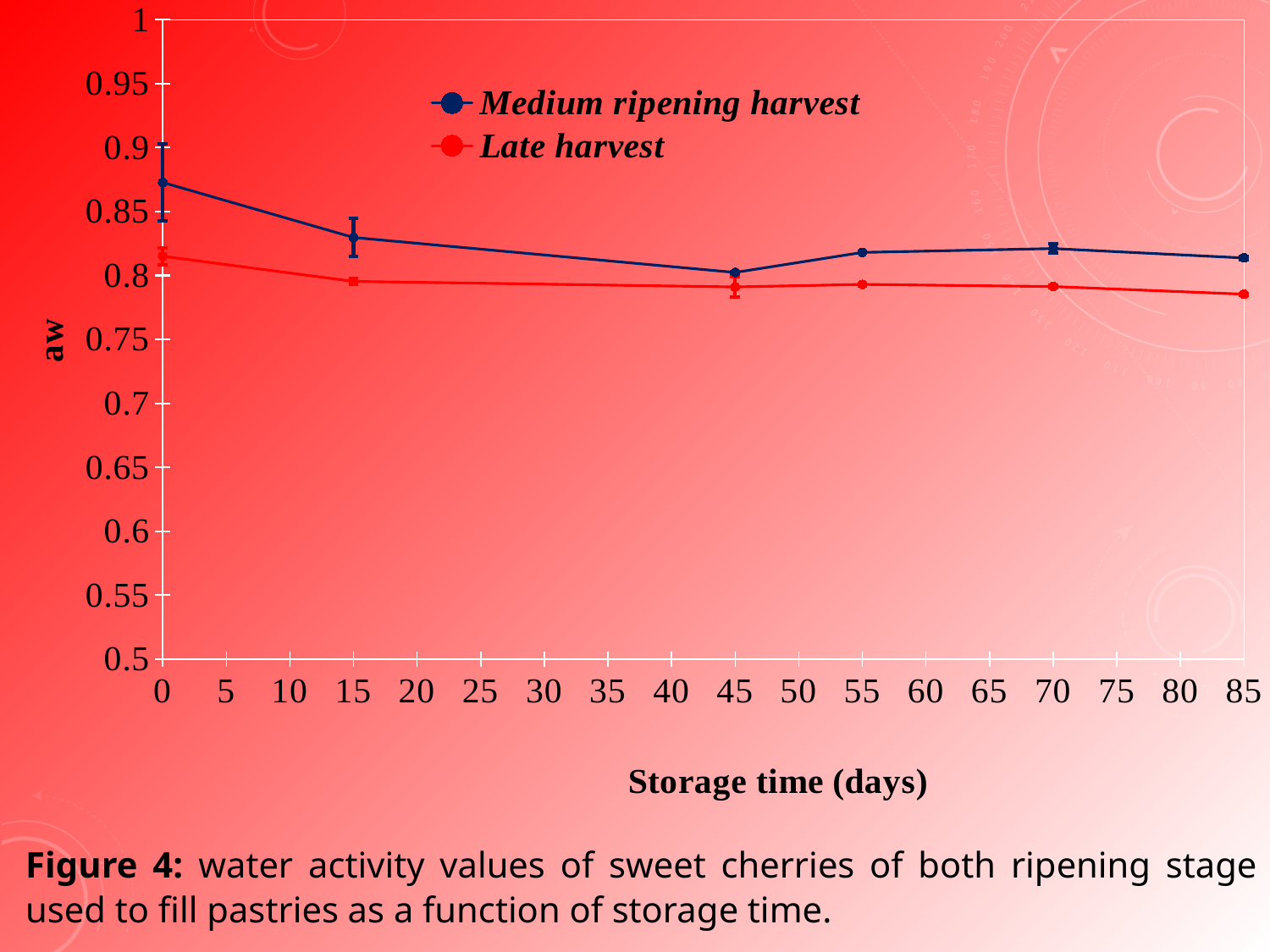
Does the Medium ripening harvest series rise or fall between 0 and 45 days? fall At which storage time does the Medium ripening harvest series reach its highest value? 0 days At 85 days, which series has the higher water activity value, Medium ripening harvest or Late harvest? Medium ripening harvest Is the value for Late harvest at 85 days greater or less than 0.8? less How many storage-time points are plotted for the Medium ripening harvest series? 6 How many series does the legend list? 2 At 0 days, which series has the higher water activity value, Medium ripening harvest or Late harvest? Medium ripening harvest What is the title of the x axis? Storage time (days) Is the value for Medium ripening harvest at 15 days greater or less than 0.85? less Is the value for Late harvest at 0 days greater or less than 0.85? less What kind of chart is shown on the slide? line chart